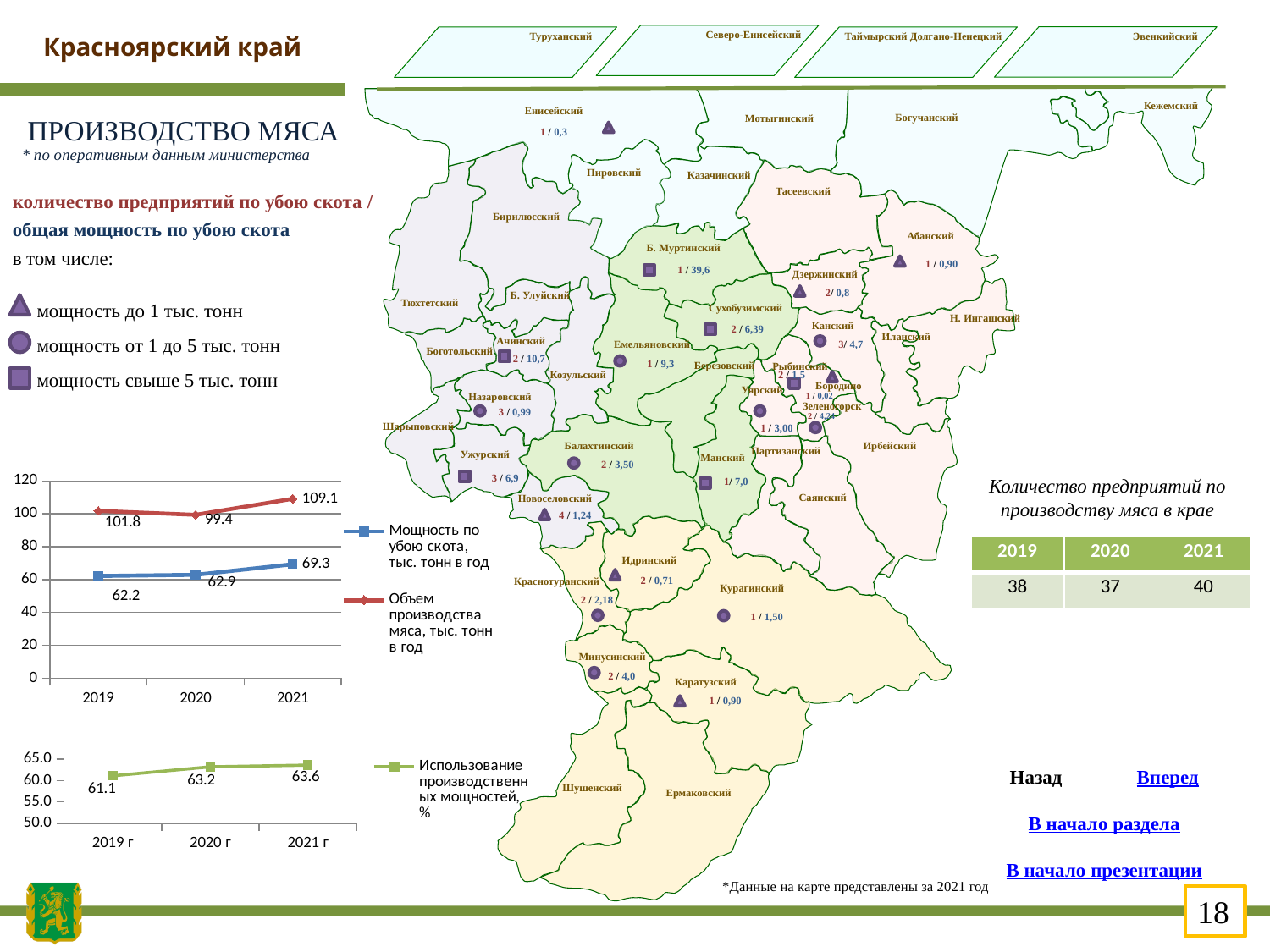
In the lower line chart, does the value rise or fall from 2019 г to 2021 г? Rise What type of chart is the upper chart on the slide? Line chart In the upper line chart, what is the value of 'Объем производства мяса, тыс. тонн в год' for 2021? 109.1 In the lower line chart, what is the value of 'Использование производственных мощностей, %' for 2019 г? 61.1 In the upper line chart, what is the value of 'Объем производства мяса, тыс. тонн в год' for 2020? 99.4 In the lower line chart, how many years are plotted on the x axis? 3 In the upper line chart, what is the value of 'Мощность по убою скота, тыс. тонн в год' for 2019? 62.2 In the upper line chart, what is the difference between 'Объем производства мяса' and 'Мощность по убою скота' in 2021? 39.8 In the upper line chart, how many series does the legend list? 2 In the upper line chart, which year has the lowest value for 'Объем производства мяса, тыс. тонн в год'? 2020 In the lower line chart, what is the value for 2021 г? 63.6 In the upper line chart, which year has the highest value for 'Мощность по убою скота, тыс. тонн в год'? 2021